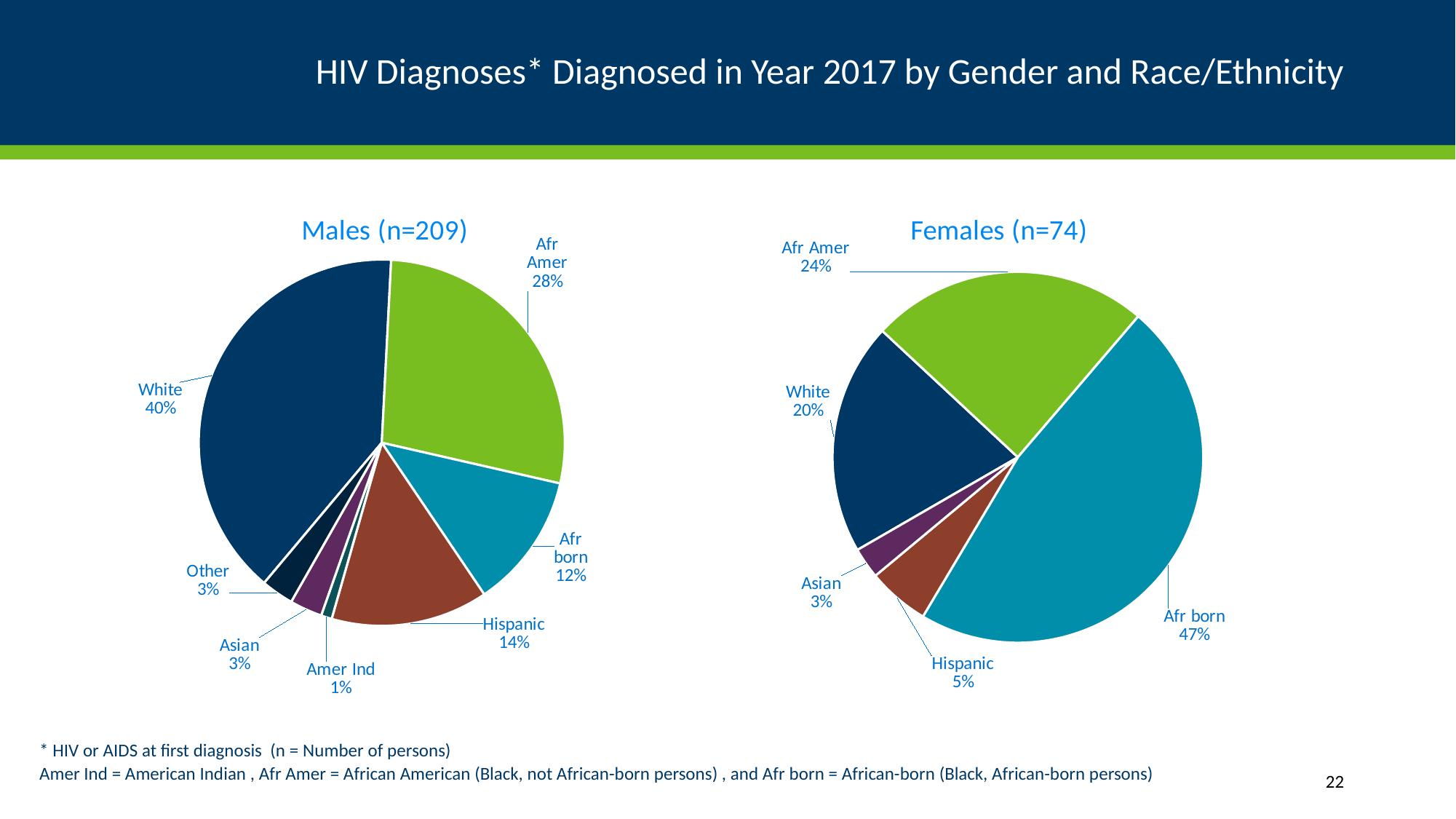
Which is larger: the Hispanic share in the Males (n=209) chart or the Hispanic share in the Females (n=74) chart? Males (n=209) In the Males (n=209) chart, which category has the smallest share? Amer Ind How many categories are shown in the Males (n=209) chart? 7 In the Females (n=74) chart, what is the difference in percentage points between the Afr born and White shares? 27 In the Females (n=74) chart, which category has the smallest share? Asian In the Females (n=74) chart, what share of diagnoses is Afr born? 47% In the Males (n=209) chart, what is the difference in percentage points between the Afr Amer and Hispanic shares? 14 How many categories are shown in the Females (n=74) chart? 5 In the Males (n=209) chart, which category has the largest share? White In the Females (n=74) chart, which category has the largest share? Afr born What kind of chart is the Females (n=74) chart? Pie chart In the Males (n=209) chart, what share of diagnoses is White? 40%